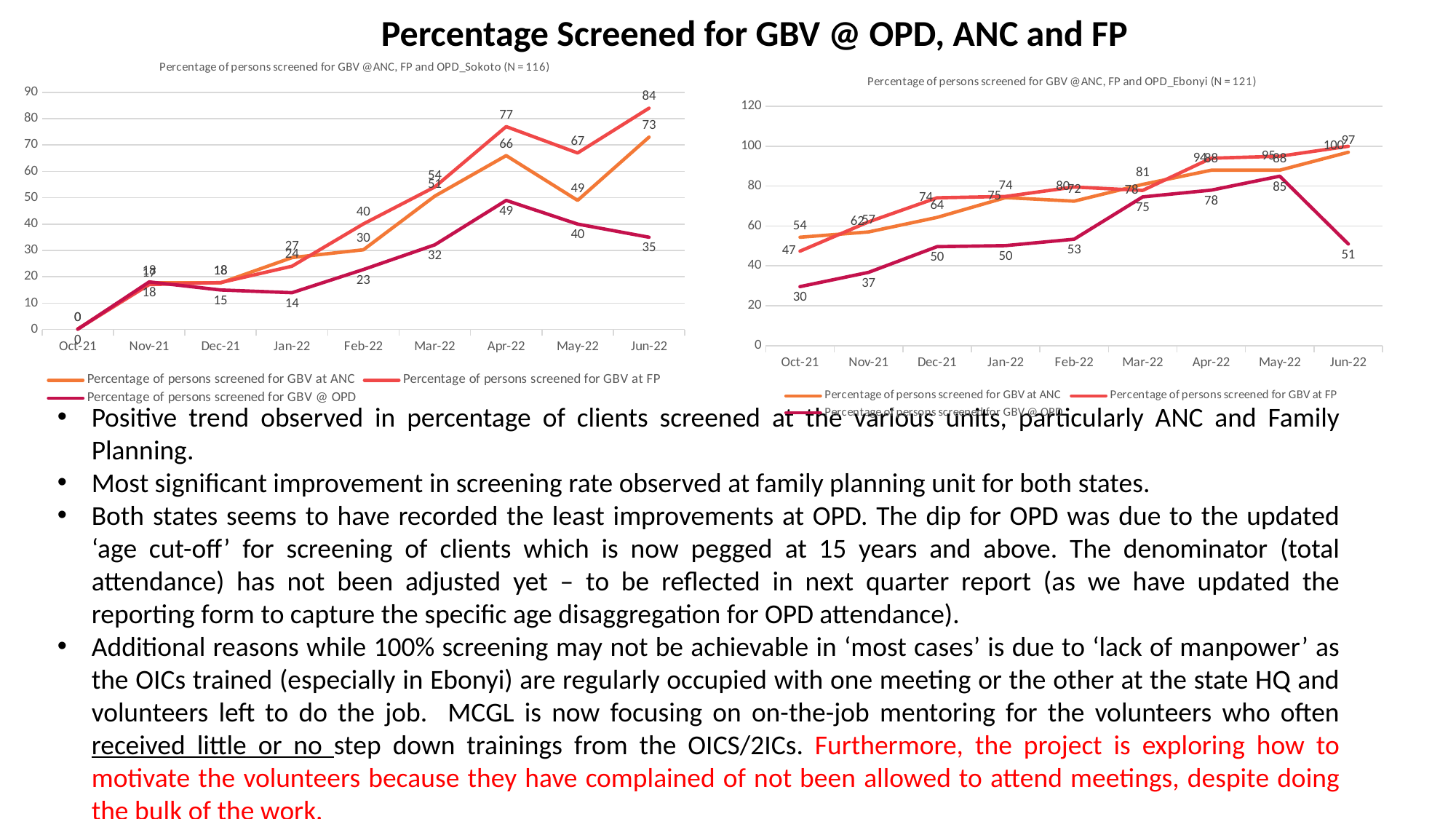
How many series does the legend of the Ebonyi chart list? 3 In the Sokoto chart, what is the percentage of persons screened for GBV at FP in Jun-22? 84 In the Ebonyi chart, what is the difference between the OPD value in May-22 (85) and in Jun-22 (51)? 34 In the Sokoto chart, in which month does the FP series reach its highest value? Jun-22 What type of chart is the Sokoto chart on the left? Line chart In the Sokoto chart, what is the difference between the FP value (84) and the ANC value (73) in Jun-22? 11 In the Ebonyi chart, what is the percentage of persons screened for GBV @ OPD in Oct-21? 30 In the Sokoto chart, which is larger in Apr-22: the FP value or the OPD value? FP In the Sokoto chart, what is the percentage of persons screened for GBV @ OPD in Jun-22? 35 How many months are plotted on the x axis of the Sokoto chart? 9 In the Ebonyi chart, does the ANC series generally rise or fall from Oct-21 to Jun-22? Rise In the Ebonyi chart, what is the percentage of persons screened for GBV @ OPD in Jun-22? 51